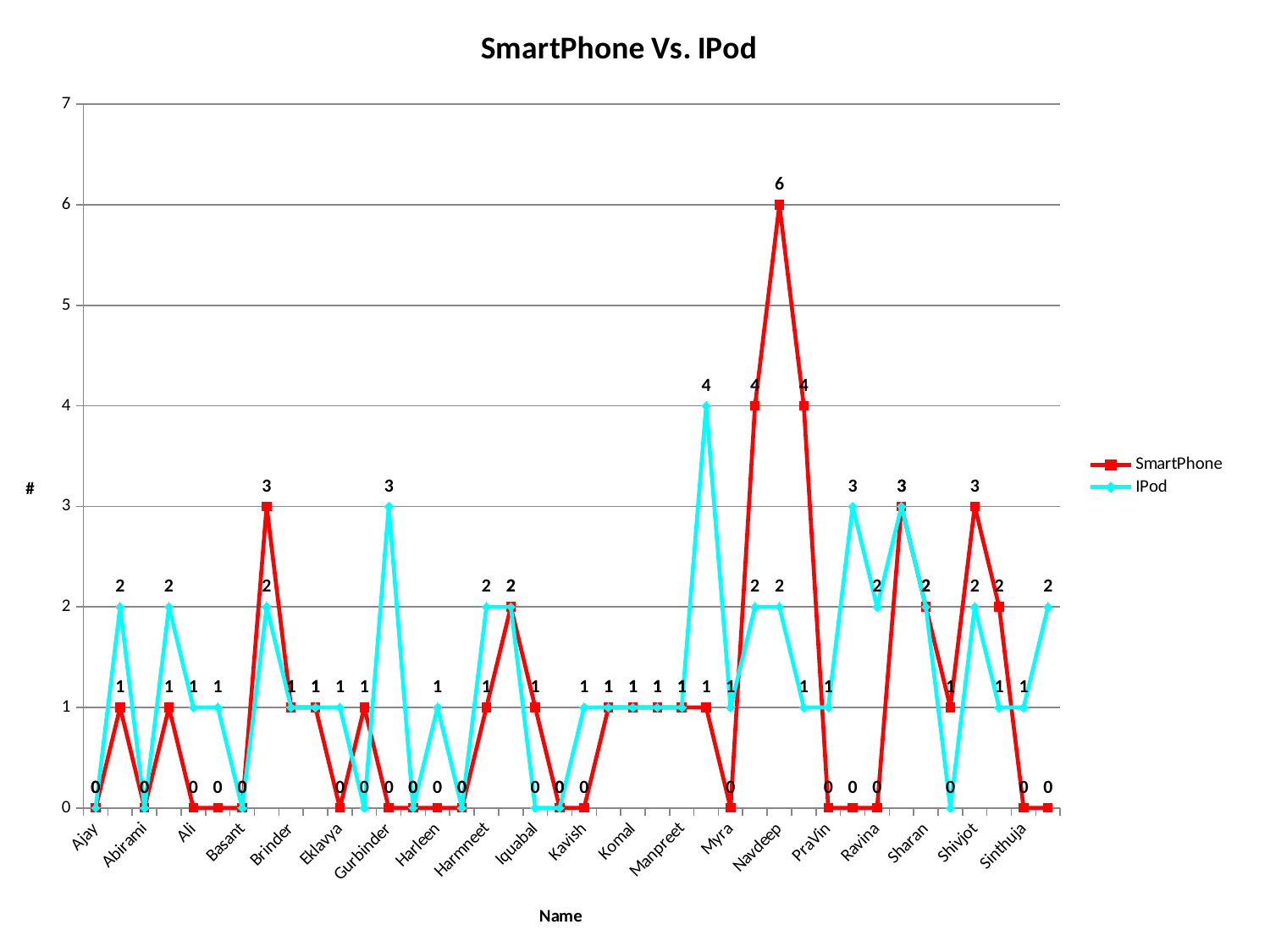
What is the highest value reached by the IPod series? 4 For Gurbinder, which series has the larger value, SmartPhone or IPod? IPod What type of chart is shown on the slide? line chart What is the title of the chart? SmartPhone Vs. IPod What is the IPod value for Gurbinder? 3 What is the SmartPhone value for Navdeep? 6 What is the SmartPhone value for Shivjot? 3 Which name has the highest SmartPhone value? Navdeep For Navdeep, what is the difference between the SmartPhone value and the IPod value? 4 What is the IPod value for Ravina? 2 What is the x-axis title of the chart? Name How many series does the legend list? 2